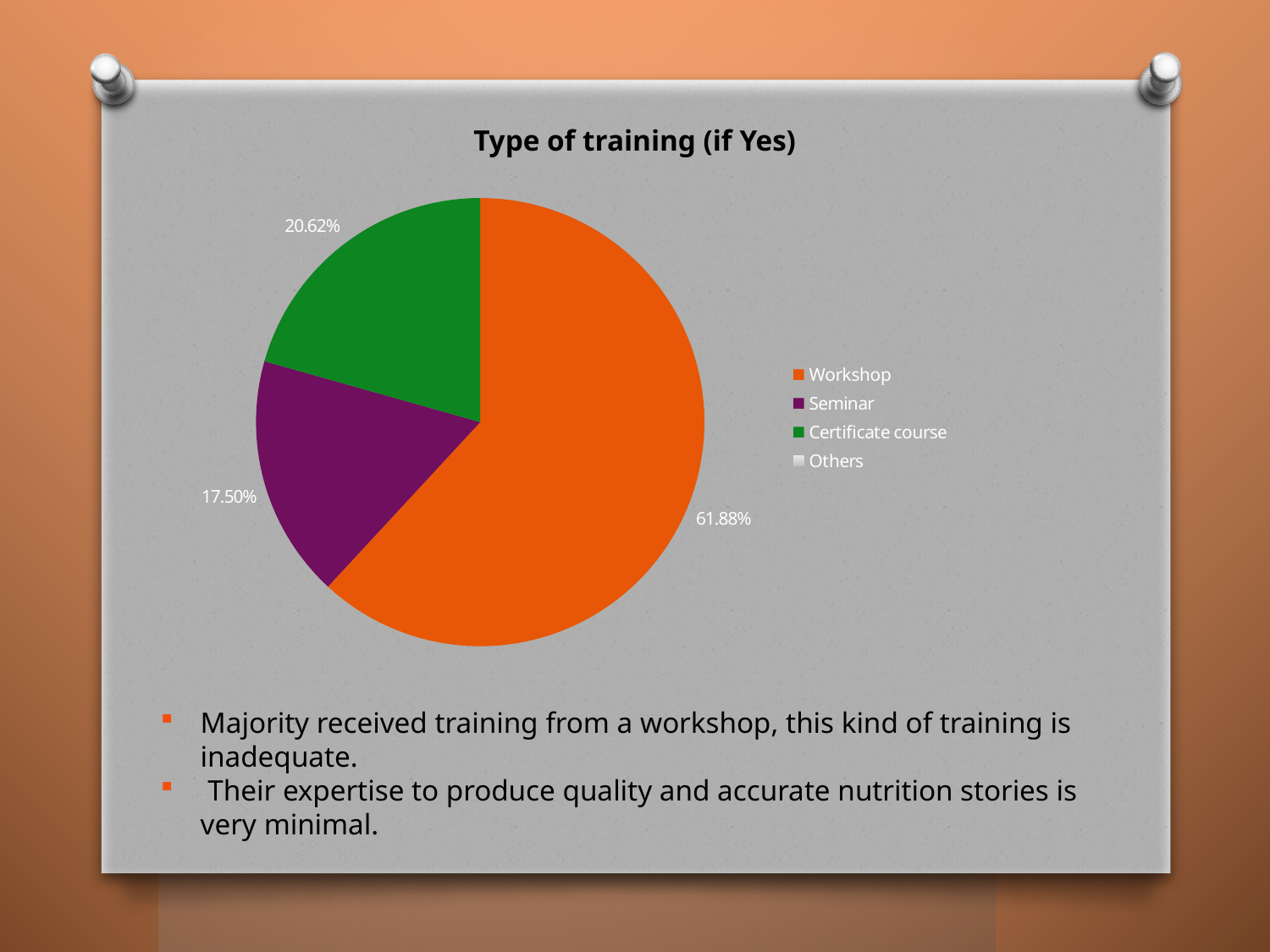
What is the difference between the Certificate course share and the Seminar share? 3.12% What colour is the Seminar slice? purple What is the difference between the Workshop share and the Certificate course share? 41.26% Which is larger, the share for Certificate course or the share for Seminar? Certificate course How many entries does the legend list? 4 What is the title of the chart? Type of training (if Yes) What percentage of the pie is Seminar? 17.50% Which labelled slice has the smallest share of the pie? Seminar What type of chart is shown on the slide? pie chart Which type of training has the largest share of the pie? Workshop What percentage of the pie is Certificate course? 20.62% What percentage of the pie is Workshop? 61.88%